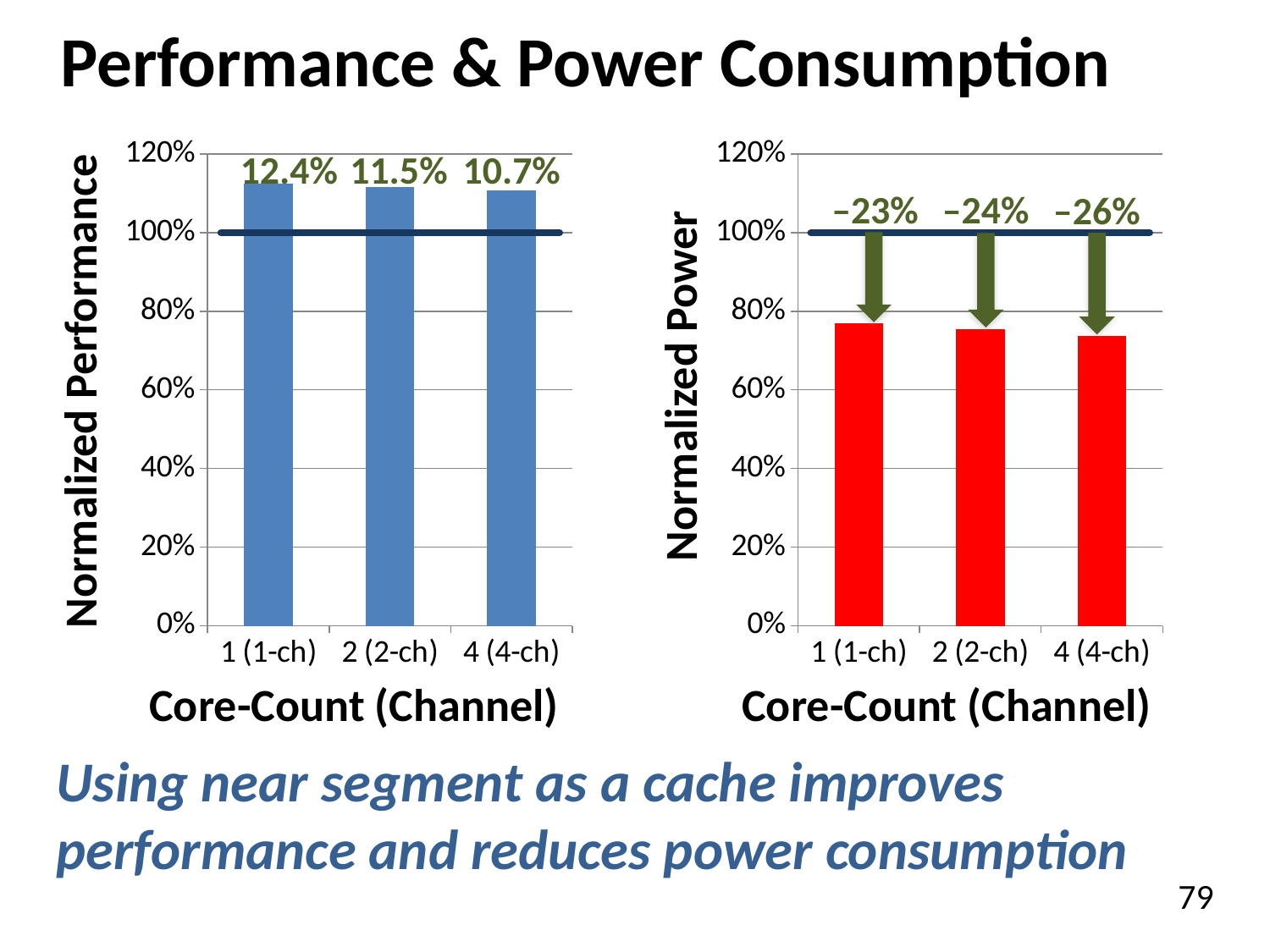
On the left chart (Normalized Performance), which core-count configuration has the largest labeled performance improvement? 1 (1-ch) On the left chart (Normalized Performance), is the normalized performance for 2 (2-ch) greater or less than 100%? greater On the right chart (Normalized Power), what power reduction is labeled above the bar for 4 (4-ch)? –26% On the left chart (Normalized Performance), what performance improvement is labeled above the bar for 4 (4-ch)? 10.7% On the right chart (Normalized Power), what power reduction is labeled above the bar for 2 (2-ch)? –24% How many core-count configurations are shown on the right chart (Normalized Power)? 3 On the left chart (Normalized Performance), what performance improvement is labeled above the bar for 1 (1-ch)? 12.4% What is the x-axis title of the right chart (Normalized Power)? Core-Count (Channel) What kind of chart is the left chart (Normalized Performance)? Bar chart On the right chart (Normalized Power), is the normalized power for 1 (1-ch) greater or less than 80%? less On the right chart (Normalized Power), which core-count configuration has the largest labeled power reduction? 4 (4-ch) On the left chart (Normalized Performance), what is the difference between the labeled improvements for 1 (1-ch) and 4 (4-ch)? 1.7 percentage points